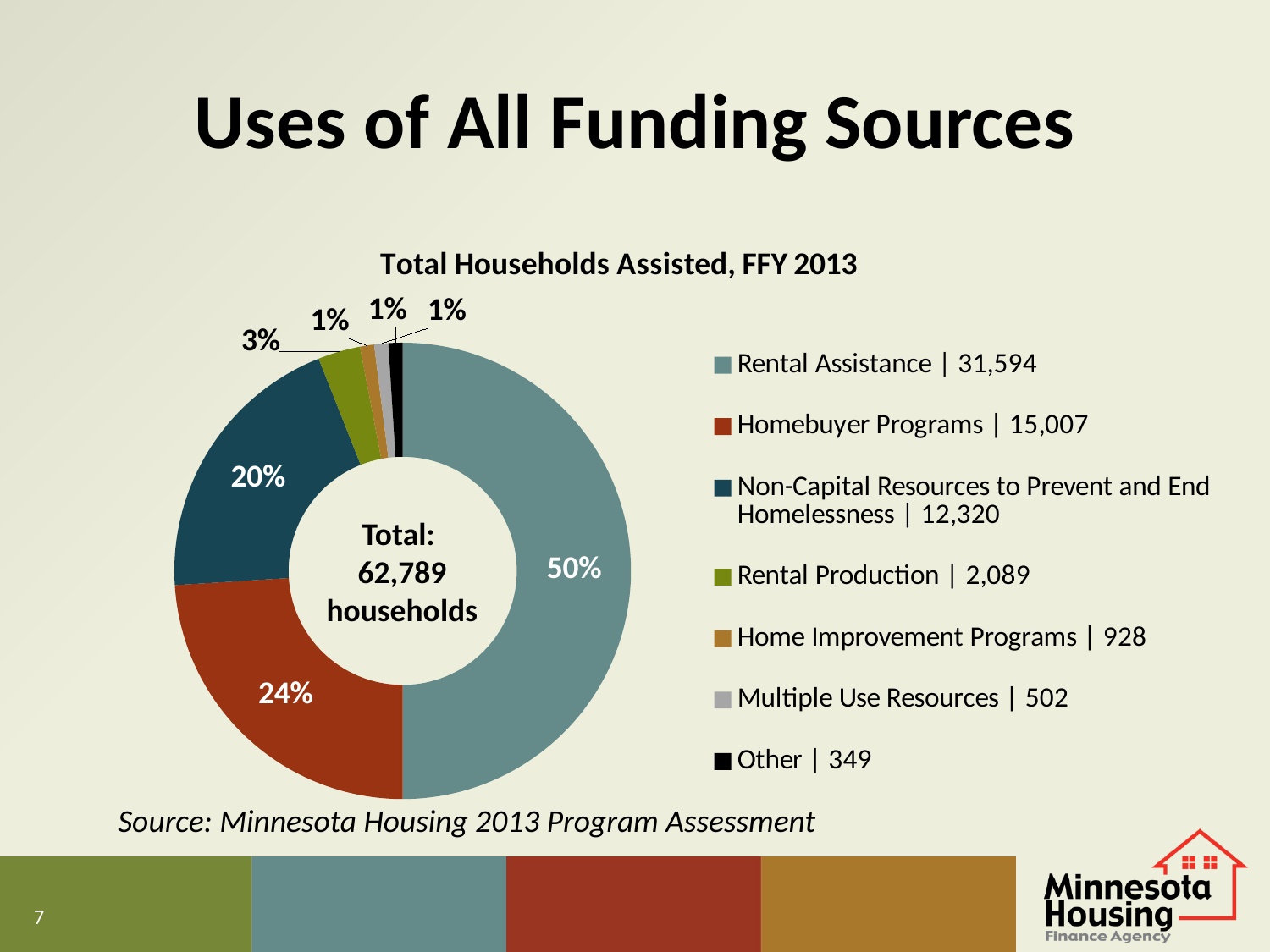
What is the difference in households assisted between Rental Assistance and Homebuyer Programs? 16,587 How many categories does the legend list? 7 What share of the pie does Non-Capital Resources to Prevent and End Homelessness represent? 20% How many households were assisted through Rental Assistance? 31,594 What kind of chart is shown on the slide? Pie chart (donut) What is the title of the chart? Total Households Assisted, FFY 2013 What share of the pie does Rental Assistance represent? 50% Which category has the smallest number of households assisted? Other How many households were assisted through Homebuyer Programs? 15,007 Which category assisted more households, Rental Production or Home Improvement Programs? Rental Production Which category has the largest number of households assisted? Rental Assistance What is the total number of households shown in the centre of the chart? 62,789 households